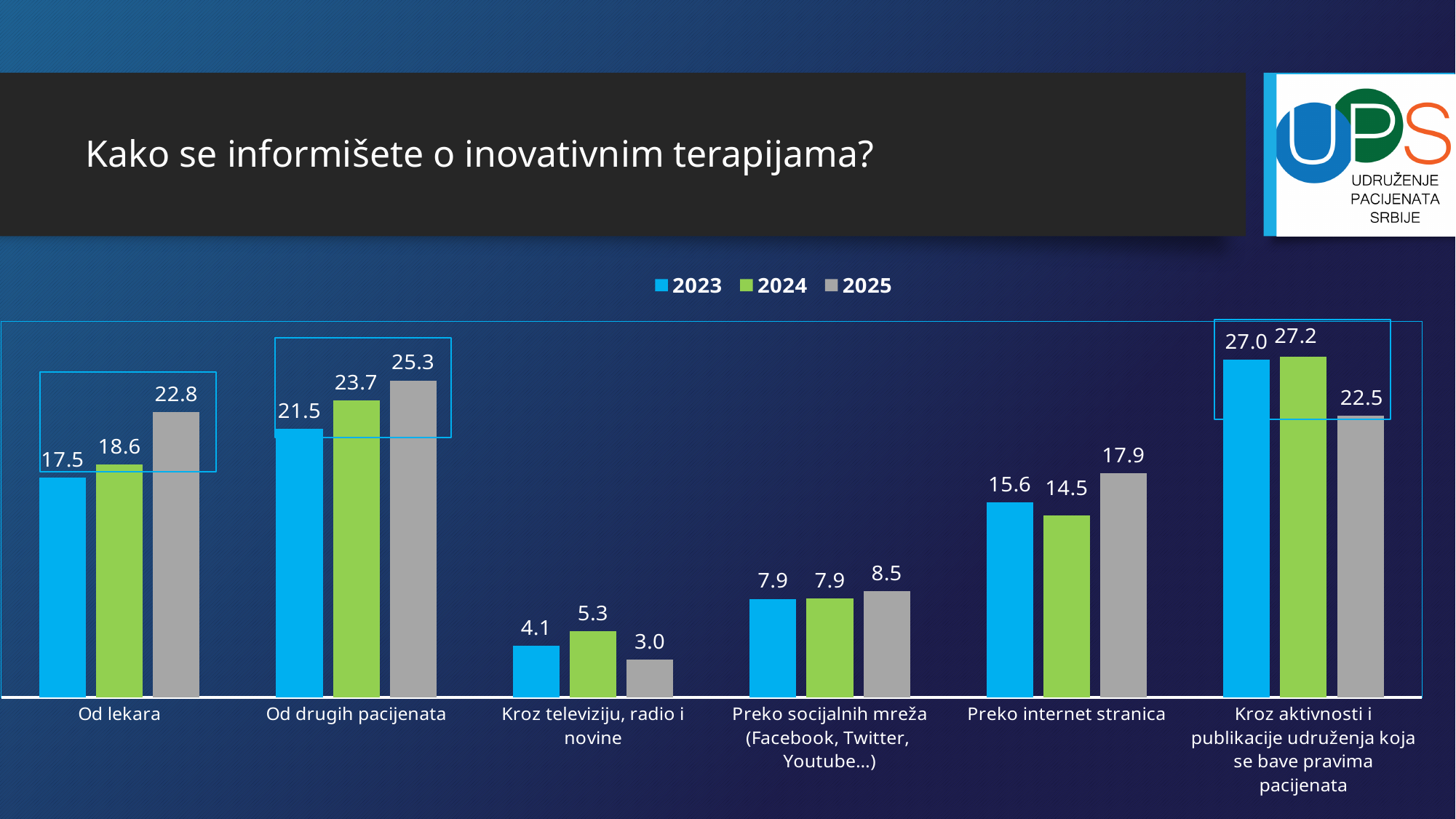
Which category has the lowest 2025 value? Kroz televiziju, radio i novine How many series does the legend list? 3 Which is larger for "Preko internet stranica": the 2023 value or the 2024 value? 2023 What is the 2024 value for "Kroz televiziju, radio i novine"? 5.3 What is the 2023 value for "Od drugih pacijenata"? 21.5 Do the values for "Od lekara" rise or fall from 2023 to 2025? Rise What is the 2025 value for "Od lekara"? 22.8 Which category has the highest 2024 value? Kroz aktivnosti i publikacije udruženja koja se bave pravima pacijenata What is the difference between the 2025 and 2023 values for "Od drugih pacijenata"? 3.8 What is the title of the chart? Kako se informišete o inovativnim terapijama? What kind of chart is shown on the slide? Bar chart How many categories are shown on the x axis? 6